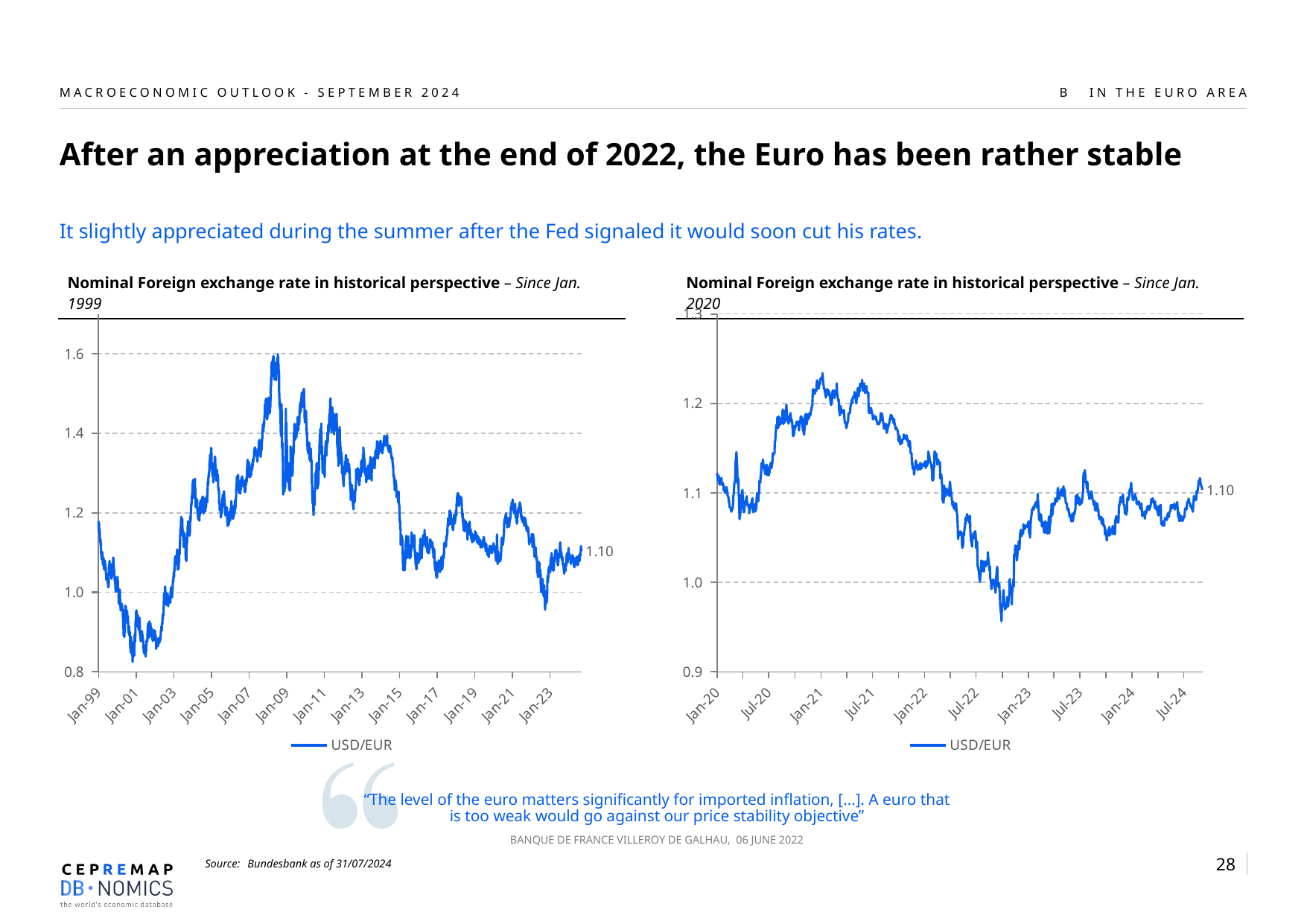
How many series does the legend of the right chart (since Jan. 2020) list? 1 On the right chart (since Jan. 2020), does the USD/EUR line rise or fall between Jan-21 and Jul-22? fall On the left chart (since Jan. 1999), is the USD/EUR value at Jan-01 greater or less than 1.0? less On the left chart (since Jan. 1999), is the USD/EUR value at Jan-13 greater or less than 1.2? greater On the right chart (since Jan. 2020), is the lowest value reached by the USD/EUR line greater or less than 1.0? less How many x-axis tick labels are shown on the right chart (since Jan. 2020)? 10 On the left chart (since Jan. 1999), what is the latest value labeled at the end of the USD/EUR line? 1.10 What is the name of the series shown in the legend of the left chart (since Jan. 1999)? USD/EUR What type of chart is the left chart, 'Nominal Foreign exchange rate in historical perspective – Since Jan. 1999'? Line chart On the right chart (since Jan. 2020), what is the latest value labeled at the end of the USD/EUR line? 1.10